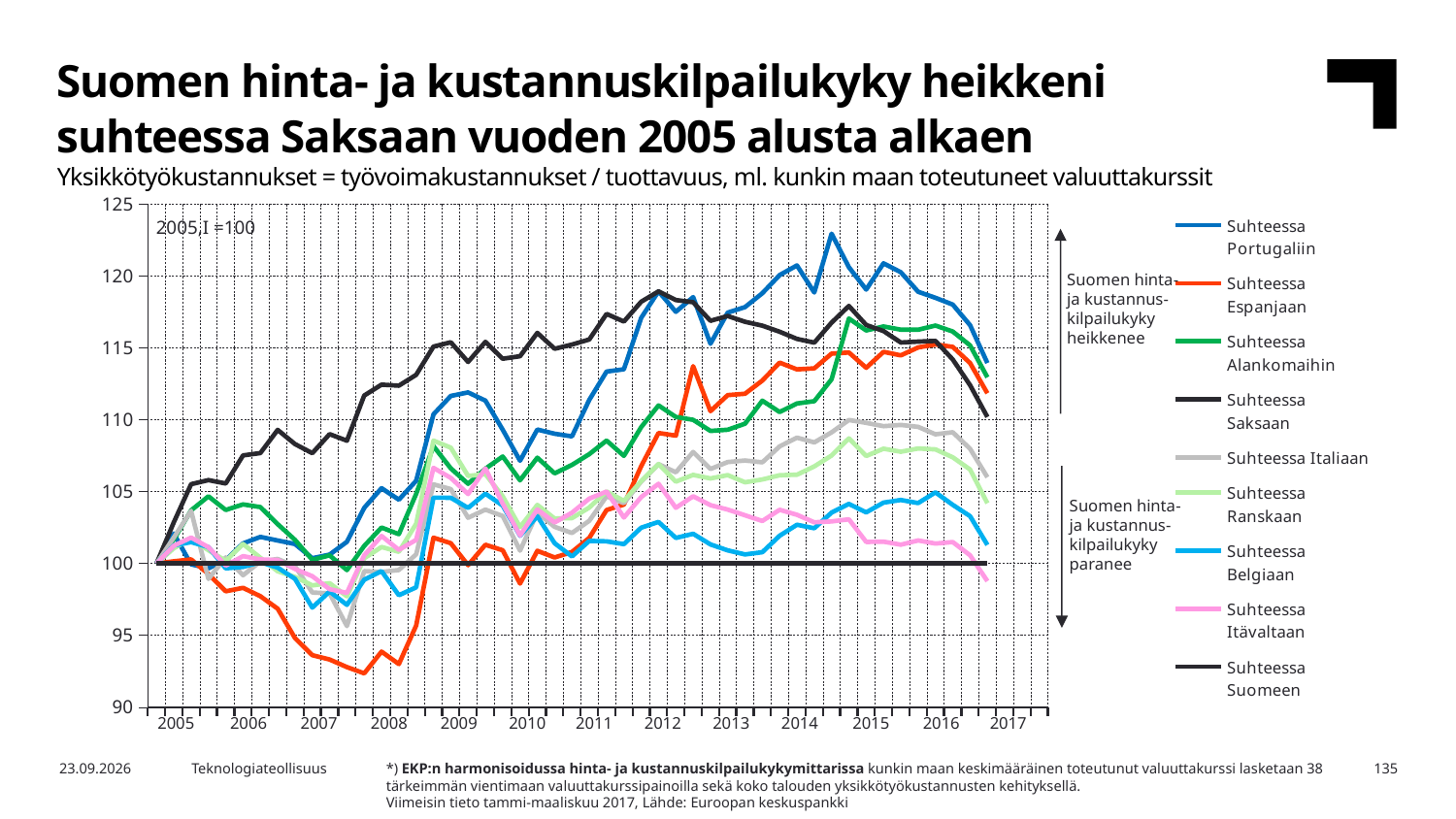
Which series reaches the highest value on the chart? Suhteessa Portugaliin Which series falls to the lowest value on the chart? Suhteessa Espanjaan Is the value of Suhteessa Saksaan in 2012 greater or less than 115? greater Is the peak value of Suhteessa Portugaliin around 2014 greater or less than 120? greater What kind of chart is shown on the slide? line chart Does the Suhteessa Saksaan series rise or fall between 2005 and 2012? rise What is the index value of all series at the start of 2005, according to the note in the chart? 100 In 2014, which is higher: Suhteessa Portugaliin or Suhteessa Belgiaan? Suhteessa Portugaliin Is the lowest value of Suhteessa Espanjaan around 2007 greater or less than 95? less How many series does the legend list? 9 What base-period note is printed in the top-left corner of the chart area? 2005,I = 100 Which series stays flat at 100 throughout the whole period? Suhteessa Suomeen